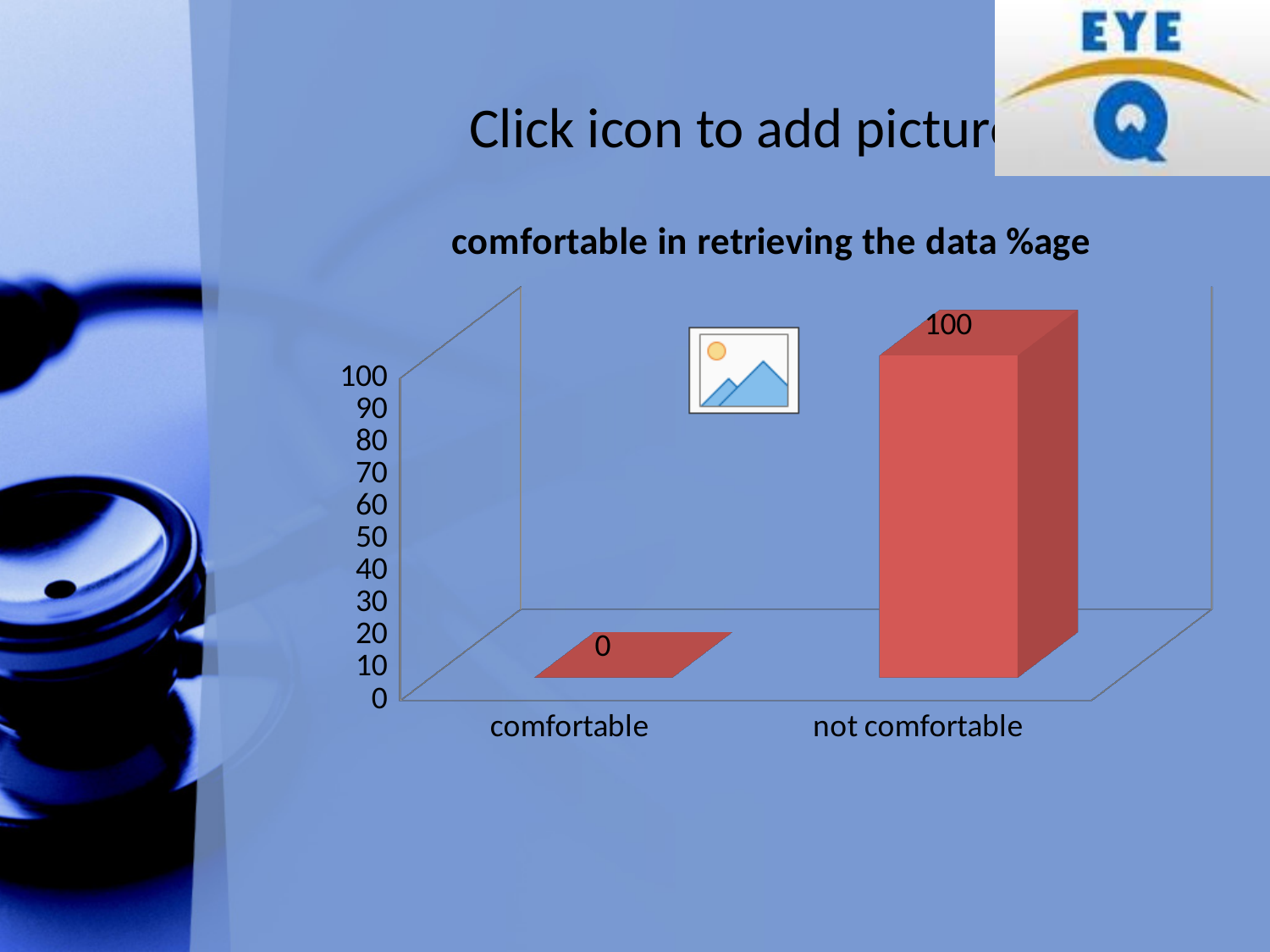
What is the value for "comfortable"? 0 What is the maximum value shown on the vertical axis? 100 How many categories are shown on the x axis? 2 What kind of chart is shown on the slide? bar chart What is the difference between the values for "not comfortable" and "comfortable"? 100 Which is larger, the value for "comfortable" or the value for "not comfortable"? not comfortable Is the value for "not comfortable" greater or less than 50? greater Which category has the lowest value? comfortable What is the value for "not comfortable"? 100 What is the title of the chart? comfortable in retrieving the data %age Which category has the highest value? not comfortable